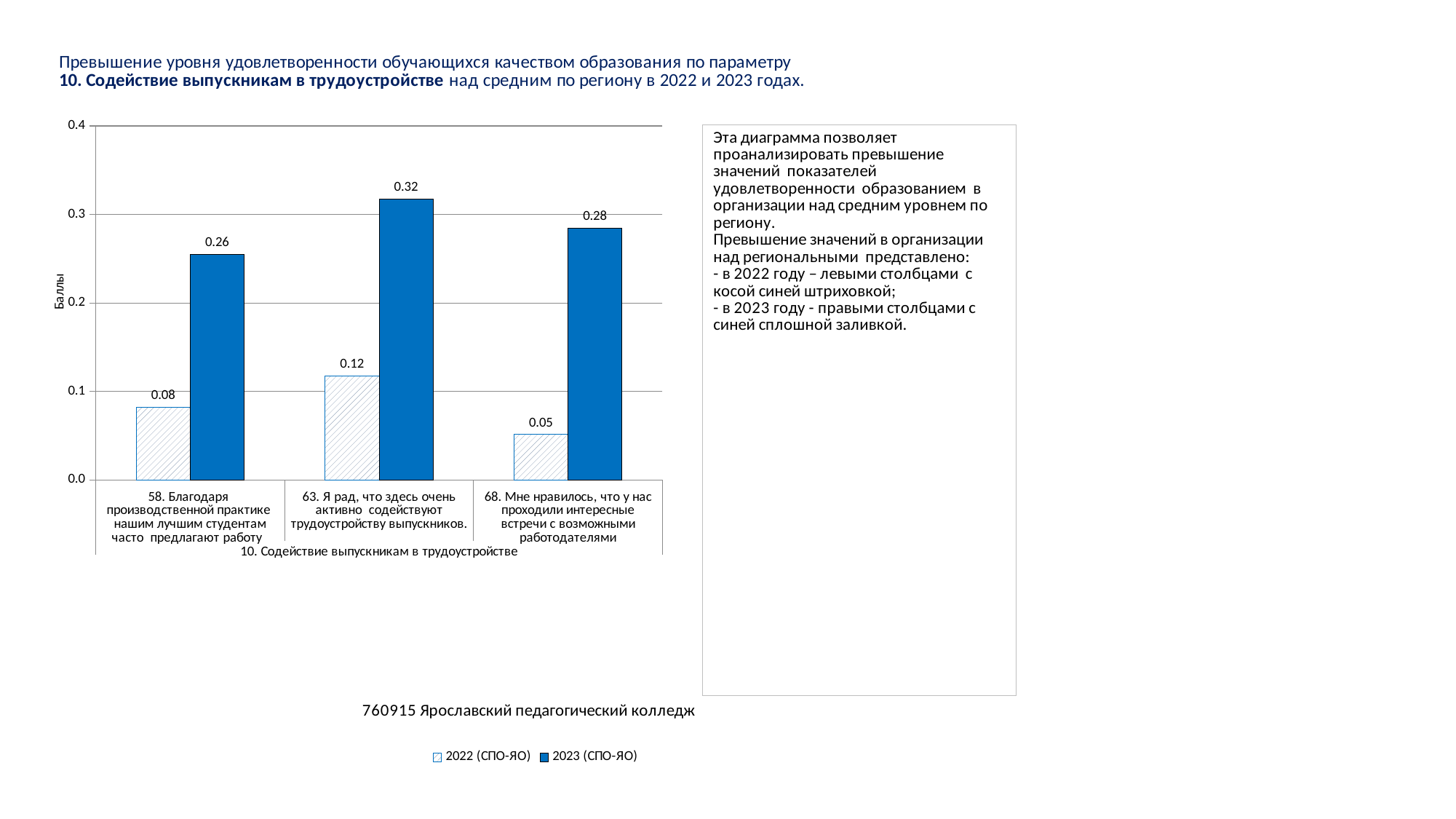
What is the value for 2023 (СПО-ЯО) for category 63 ("Я рад, что здесь очень активно содействуют трудоустройству выпускников")? 0.32 What is the label of the y axis of the chart? Баллы Which category has the highest value for 2023 (СПО-ЯО)? 63. Я рад, что здесь очень активно содействуют трудоустройству выпускников. Is the 2023 (СПО-ЯО) value for category 58 greater or less than 0.3? less Which category has the lowest value for 2022 (СПО-ЯО)? 68. Мне нравилось, что у нас проходили интересные встречи с возможными работодателями What is the difference between the 2023 and 2022 values for category 58? 0.18 How many series does the legend list? 2 What is the value for 2022 (СПО-ЯО) for category 68 ("Мне нравилось, что у нас проходили интересные встречи с возможными работодателями")? 0.05 How many categories are shown on the x axis of the chart? 3 What kind of chart is shown on the slide? bar chart What is the value for 2022 (СПО-ЯО) for category 58 ("Благодаря производственной практике нашим лучшим студентам часто предлагают работу")? 0.08 Which is larger for category 68: the 2022 (СПО-ЯО) value or the 2023 (СПО-ЯО) value? 2023 (СПО-ЯО)